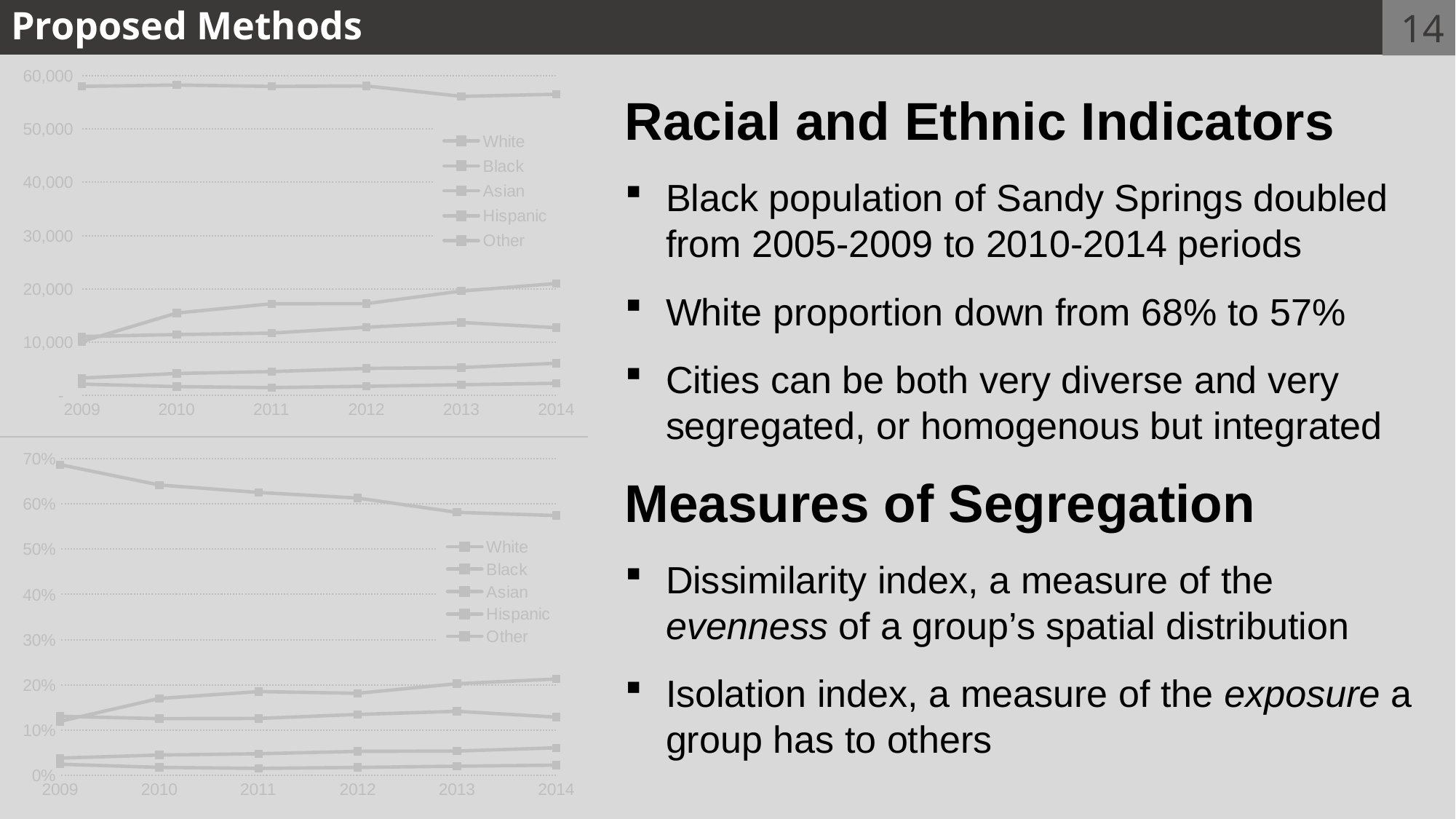
In the bottom chart, does the highest line rise or fall from 2009 to 2014? Fall How many years are plotted along the x axis of the bottom chart? 6 What kind of chart is the top chart on the slide? Line chart Which series are listed in the legend of the bottom chart? White, Black, Asian, Hispanic, Other What is the first year shown on the x axis of the top chart? 2009 How many series does the legend of the top chart list? 5 In the bottom chart, is the lowest line's value in 2014 greater or less than 10%? less In the bottom chart, is the highest line's value in 2009 greater or less than 60%? greater What kind of chart is the bottom chart on the slide? Line chart In the bottom chart, is the highest line's value in 2014 greater or less than 60%? less